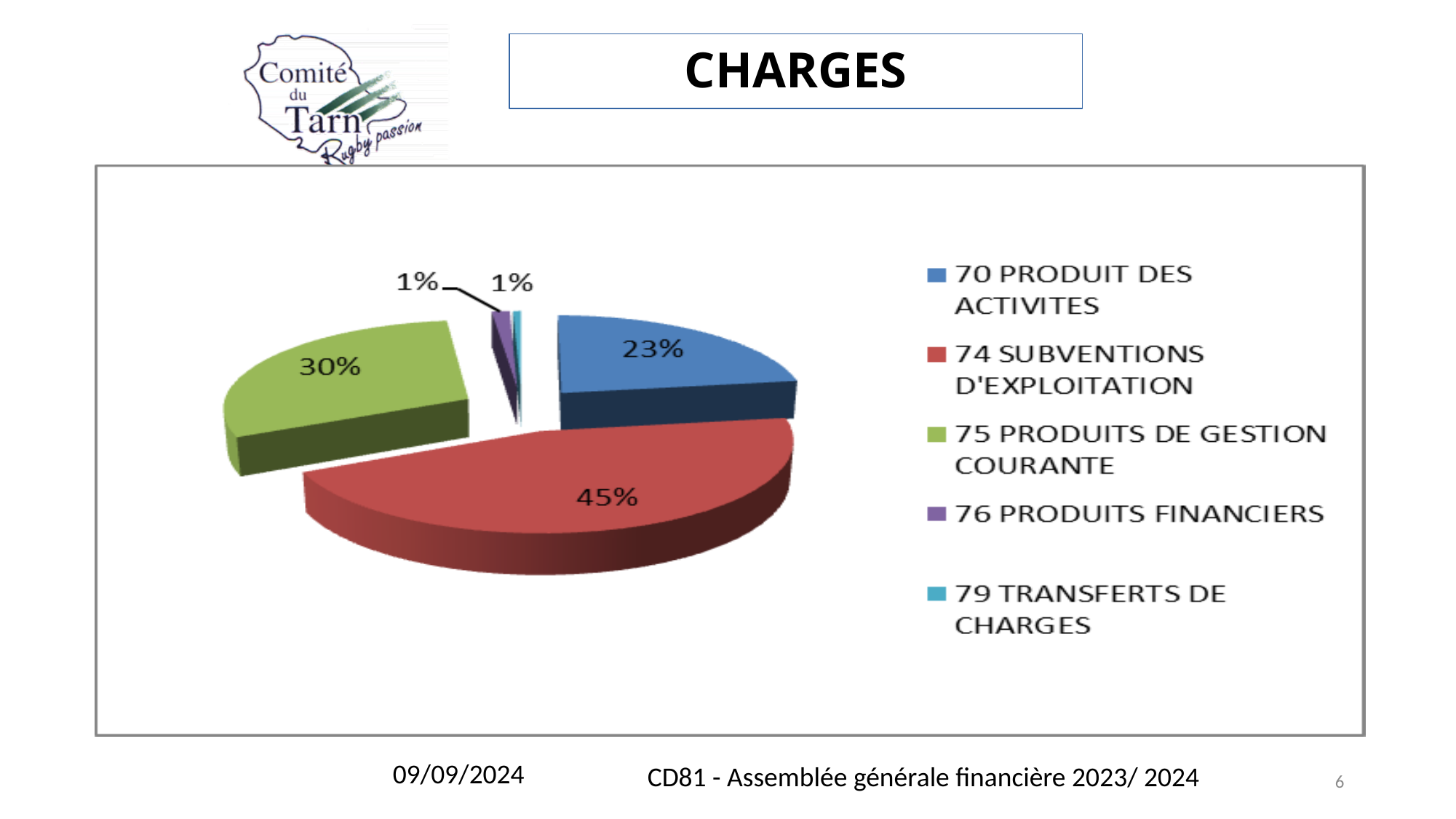
Which category has the largest slice of the pie? 74 SUBVENTIONS D'EXPLOITATION What is the difference in percentage points between the 75 PRODUITS DE GESTION COURANTE slice and the 70 PRODUIT DES ACTIVITES slice? 7% How many categories does the legend list? 5 What kind of chart is shown on the slide? pie chart What is the title shown above the chart? CHARGES What share of the pie does 75 PRODUITS DE GESTION COURANTE represent? 30% What share of the pie does 70 PRODUIT DES ACTIVITES represent? 23% What share of the pie does 76 PRODUITS FINANCIERS represent? 1% What is the difference in percentage points between the 74 SUBVENTIONS D'EXPLOITATION slice and the 75 PRODUITS DE GESTION COURANTE slice? 15% Which is larger, the slice for 75 PRODUITS DE GESTION COURANTE or the slice for 70 PRODUIT DES ACTIVITES? 75 PRODUITS DE GESTION COURANTE